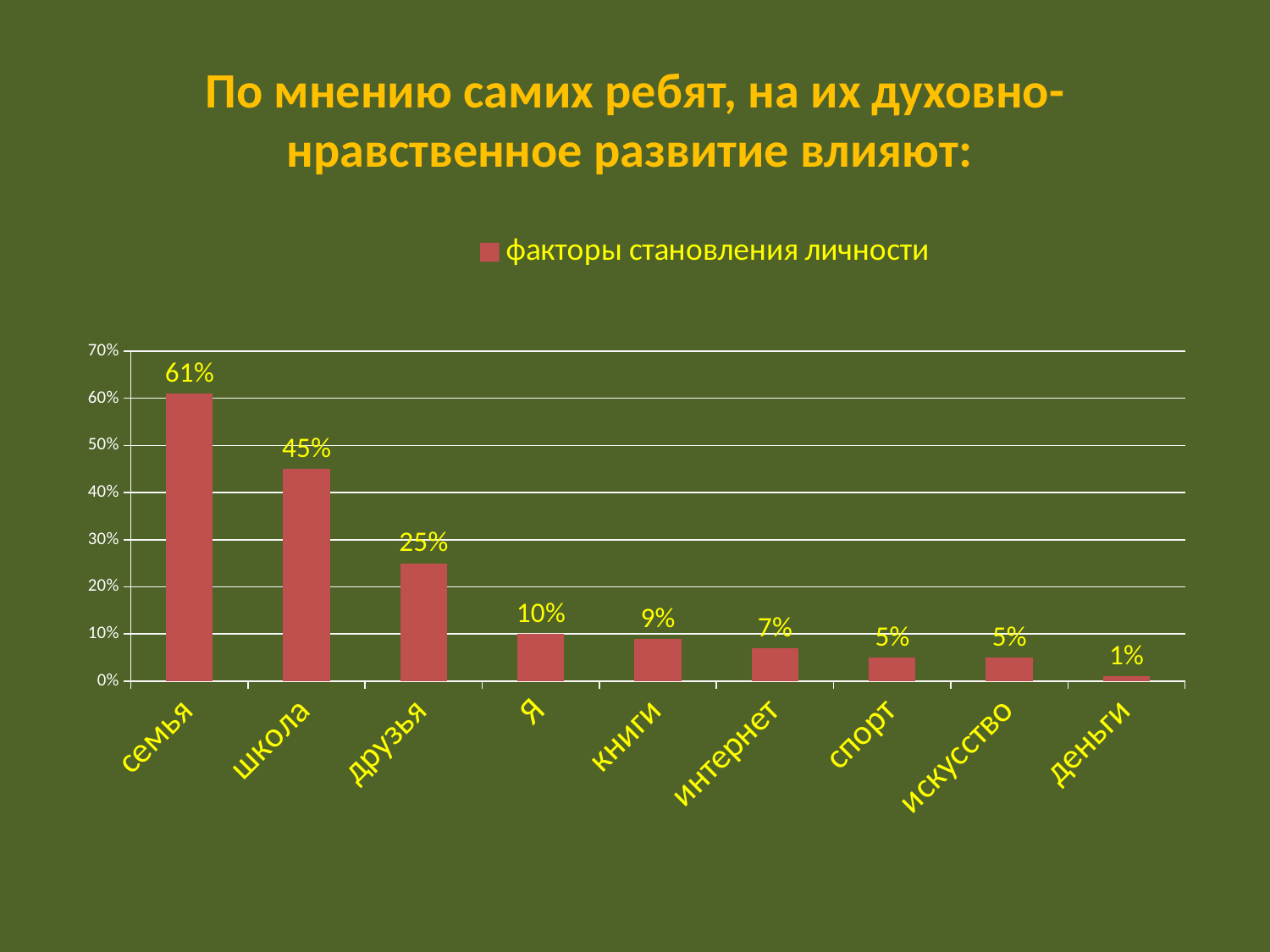
Is the value for школа greater or less than 40%? greater What is the legend entry for the series? факторы становления личности What is the value for друзья? 25% What is the value for семья? 61% What is the value for интернет? 7% How many categories are shown on the x axis? 9 What kind of chart is shown on the slide? bar chart Which category has the highest value? семья Which category has the lowest value? деньги What is the difference between the values for семья and школа? 16% Which is larger, the value for книги or the value for спорт? книги How many series does the legend list? 1